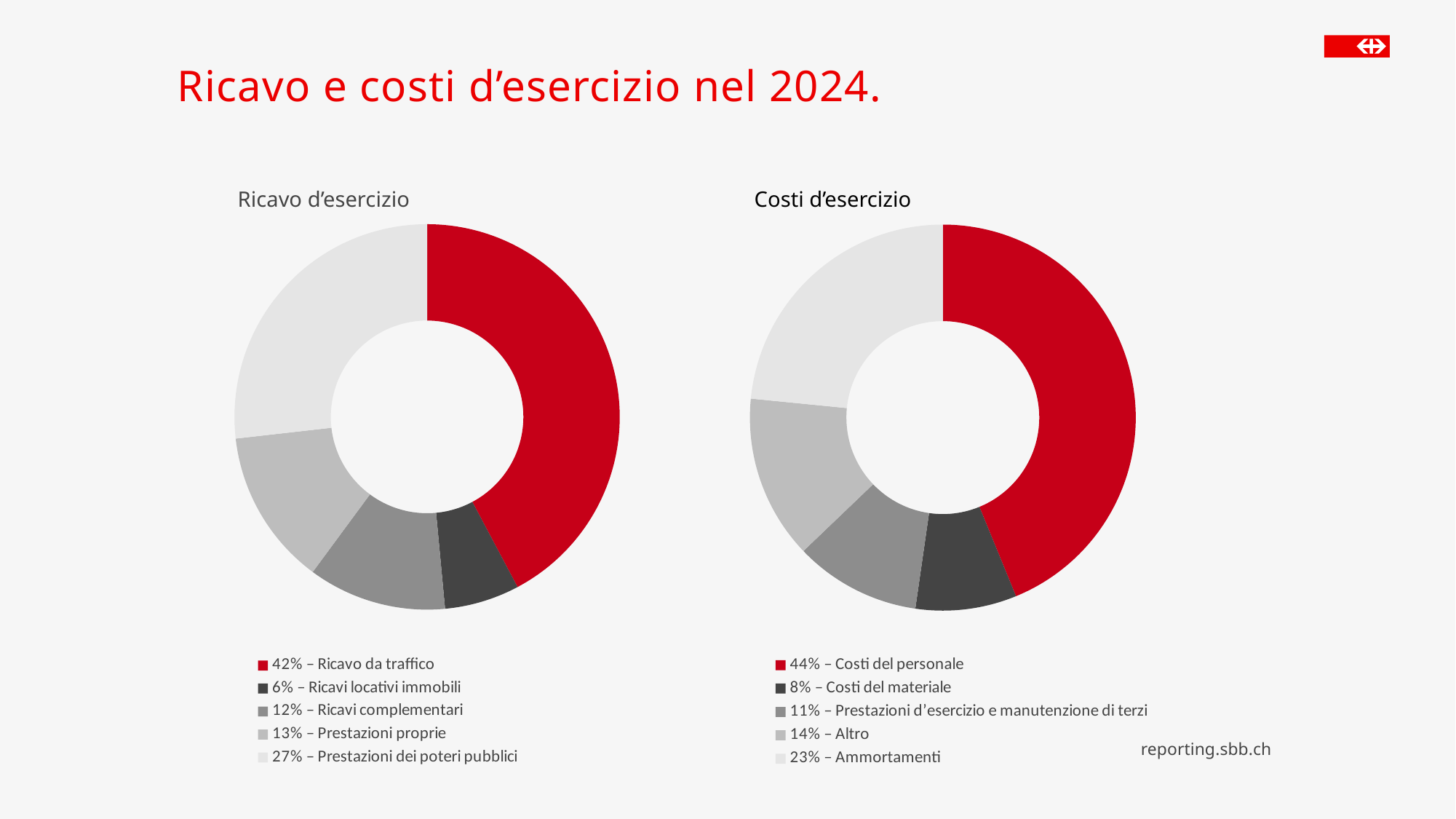
In the 'Costi d'esercizio' chart, what is the difference between 'Altro' and 'Prestazioni d'esercizio e manutenzione di terzi'? 3% In the 'Costi d'esercizio' chart, what share is 'Ammortamenti'? 23% In the 'Ricavo d'esercizio' chart, what share is 'Ricavo da traffico'? 42% In the 'Ricavo d'esercizio' chart, what is the difference between 'Ricavo da traffico' and 'Prestazioni dei poteri pubblici'? 15% What is the title of the slide? Ricavo e costi d'esercizio nel 2024. In the 'Costi d'esercizio' chart, which is larger: 'Altro' or 'Costi del materiale'? Altro In the 'Ricavo d'esercizio' chart, which category has the smallest share? Ricavi locativi immobili What kind of chart is the 'Costi d'esercizio' chart? Pie (doughnut) chart How many categories does the 'Ricavo d'esercizio' chart show? 5 In the 'Costi d'esercizio' chart, what share is 'Costi del personale'? 44% In the 'Ricavo d'esercizio' chart, what share is 'Prestazioni dei poteri pubblici'? 27% In the 'Costi d'esercizio' chart, which category has the largest share? Costi del personale